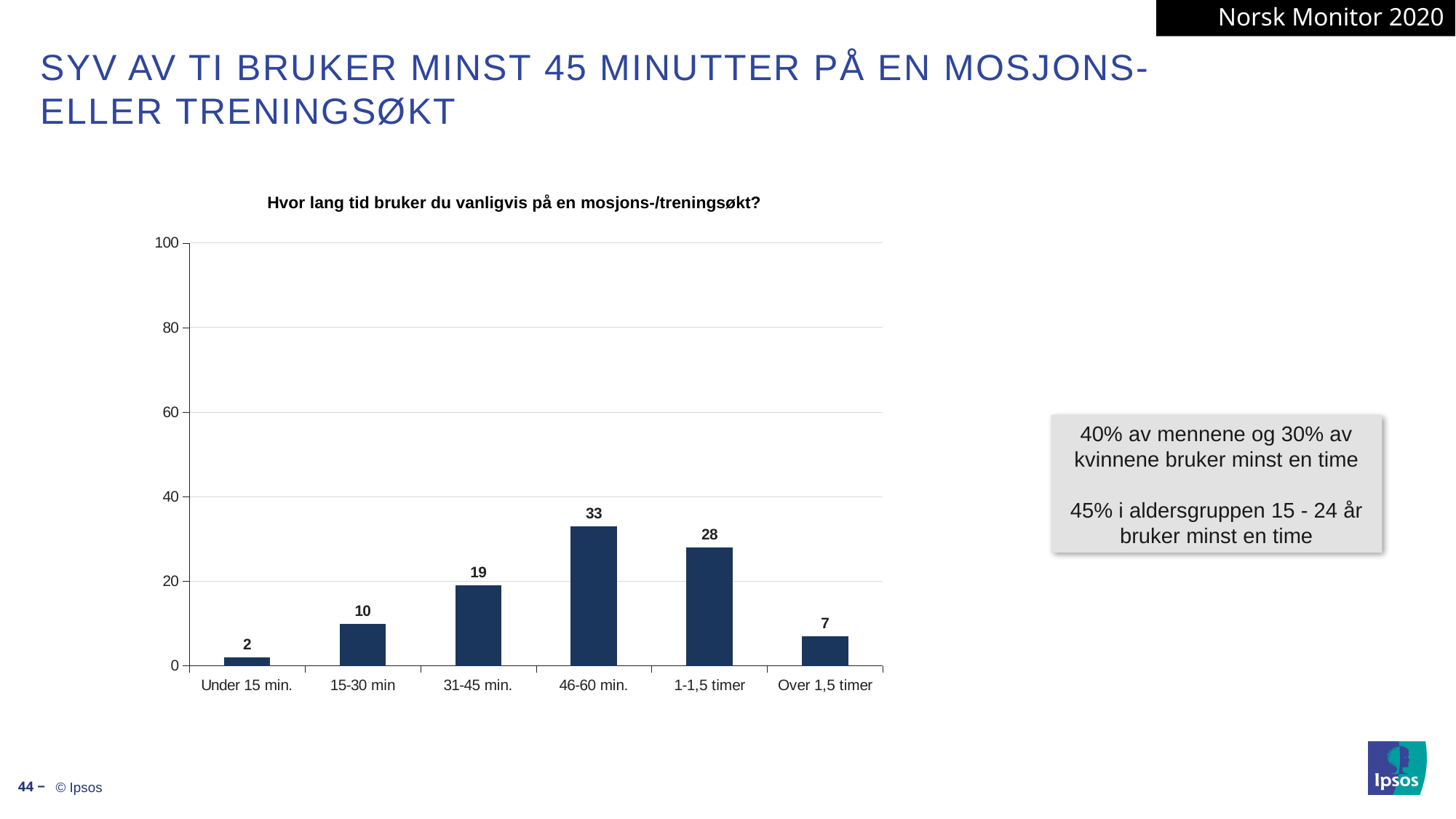
What is the value for the 'Over 1,5 timer' category? 7 What is the maximum value shown on the y axis? 100 Which category has the highest value? 46-60 min. Which is larger, the value for '15-30 min' or the value for '31-45 min.'? 31-45 min. Which category has the lowest value? Under 15 min. What kind of chart is shown on the slide? bar chart What is the difference between the values for '46-60 min.' and '1-1,5 timer'? 5 How many categories are shown on the x axis? 6 What is the value for the '46-60 min.' category? 33 What is the title of the chart? Hvor lang tid bruker du vanligvis på en mosjons-/treningsøkt? Is the value for '1-1,5 timer' greater or less than 20? greater What is the value for the 'Under 15 min.' category? 2